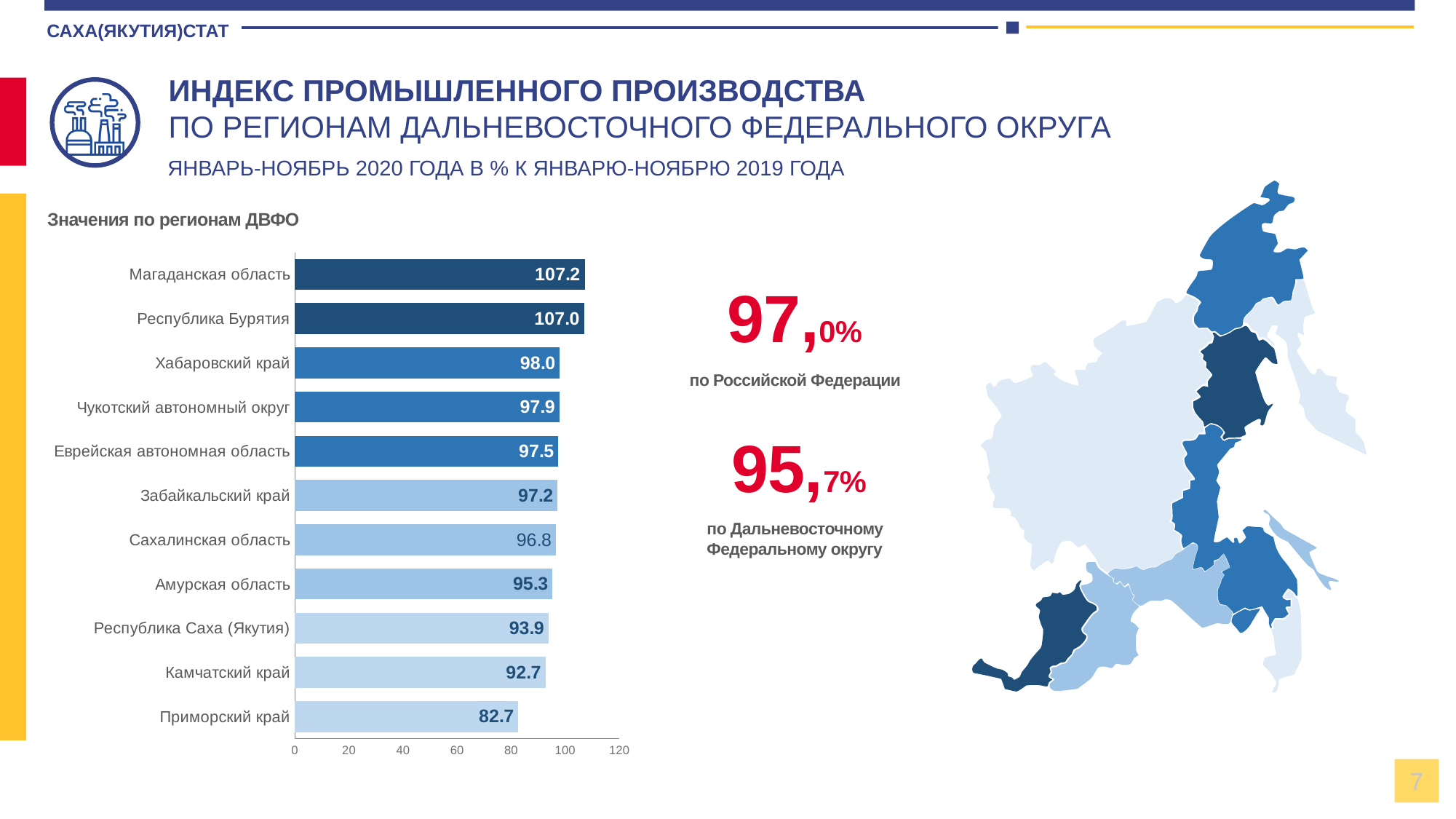
Which region has the lowest value? Приморский край What is the difference between the values for Магаданская область and Приморский край? 24.5 Which is larger, the value for Хабаровский край or the value for Амурская область? Хабаровский край Is the value for Камчатский край greater or less than 100? less What is the value for Магаданская область? 107.2 What is the value for Республика Саха (Якутия)? 93.9 What kind of chart is used to show the values by region? bar chart What is the title above the bar chart? Значения по регионам ДВФО How many regions are shown in the bar chart? 11 Which region has the highest value? Магаданская область What is the value for Сахалинская область? 96.8 What is the difference between the values for Республика Бурятия and Чукотский автономный округ? 9.1